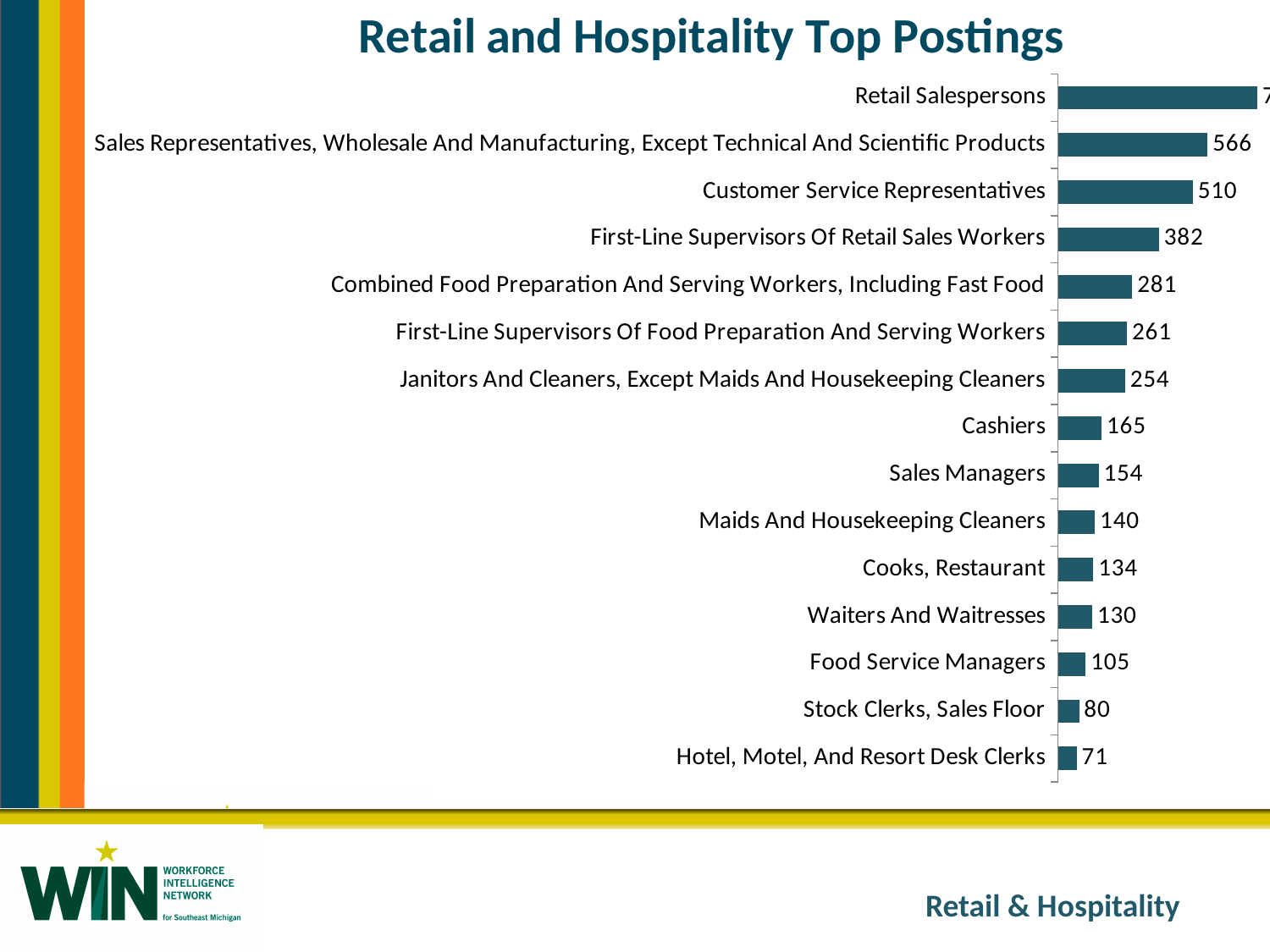
What is the value for Cashiers? 165 What kind of chart is shown on the slide? bar chart What is the value for Janitors And Cleaners, Except Maids And Housekeeping Cleaners? 254 What is the value for Customer Service Representatives? 510 Which occupation has the highest number of postings? Retail Salespersons What is the chart's title? Retail and Hospitality Top Postings Which has a larger value, First-Line Supervisors Of Retail Sales Workers or Combined Food Preparation And Serving Workers, Including Fast Food? First-Line Supervisors Of Retail Sales Workers What is the value for Hotel, Motel, And Resort Desk Clerks? 71 What is the difference between the values for Stock Clerks, Sales Floor and Hotel, Motel, And Resort Desk Clerks? 9 How many occupations are listed in the chart? 15 What is the difference between the values for Sales Representatives, Wholesale And Manufacturing, Except Technical And Scientific Products and Customer Service Representatives? 56 Which occupation has the lowest number of postings? Hotel, Motel, And Resort Desk Clerks